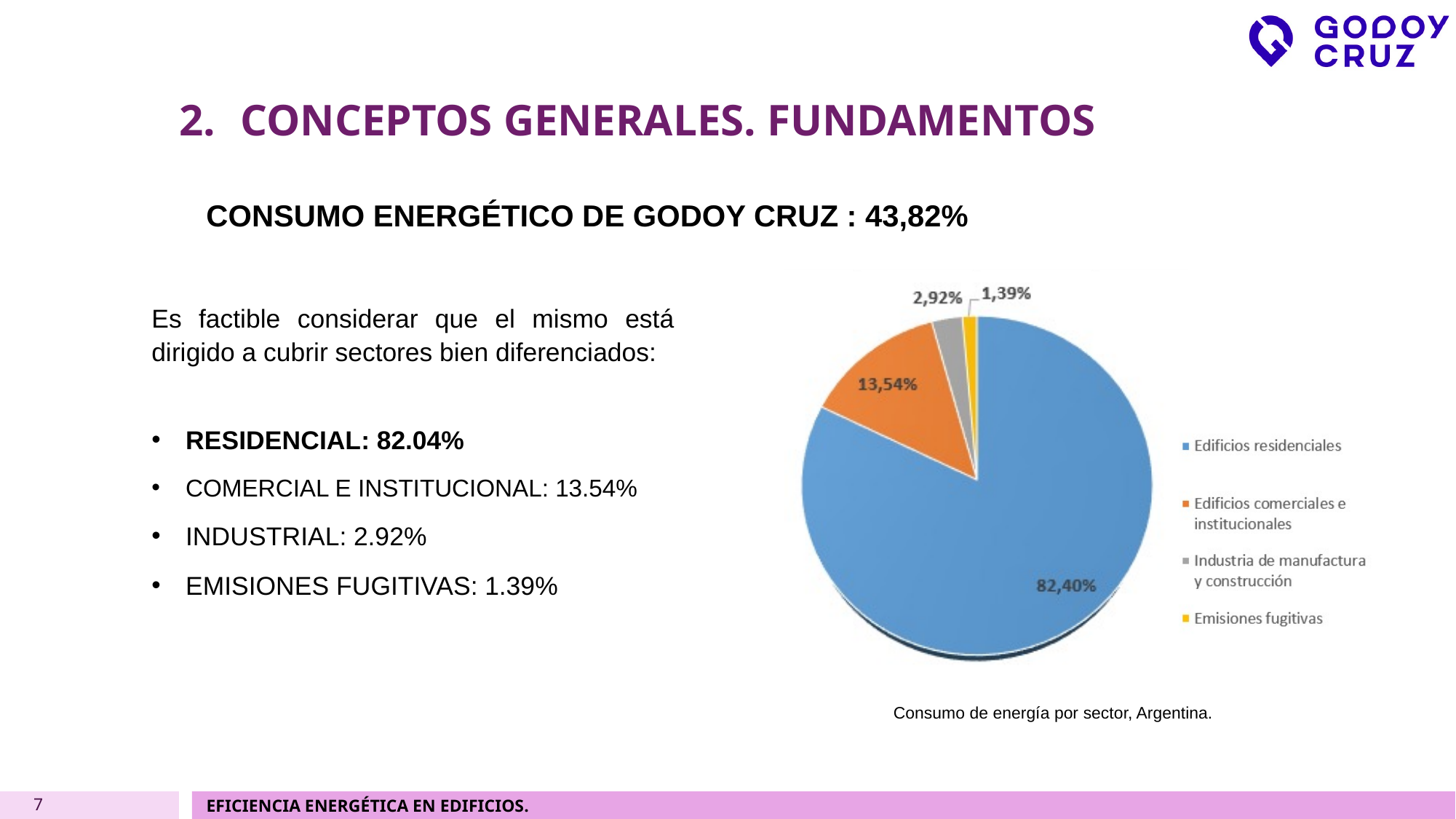
Which slice is larger in the pie chart: Edificios comerciales e institucionales or Industria de manufactura y construcción? Edificios comerciales e institucionales Which sector has the smallest slice in the pie chart? Emisiones fugitivas What colour is the Emisiones fugitivas slice in the pie chart? Yellow How many slices does the pie chart have? 4 What share of the pie chart is labelled for Industria de manufactura y construcción? 2,92% What share of the pie chart is labelled for Edificios comerciales e institucionales? 13,54% Which sector has the largest slice in the pie chart? Edificios residenciales What share of the pie chart is labelled for Edificios residenciales? 82,40% What is the difference between the Edificios residenciales slice and the Edificios comerciales e institucionales slice in the pie chart? 68,86% What kind of chart is shown on the slide? Pie chart What is the caption below the pie chart? Consumo de energía por sector, Argentina. What share of the pie chart is labelled for Emisiones fugitivas? 1,39%